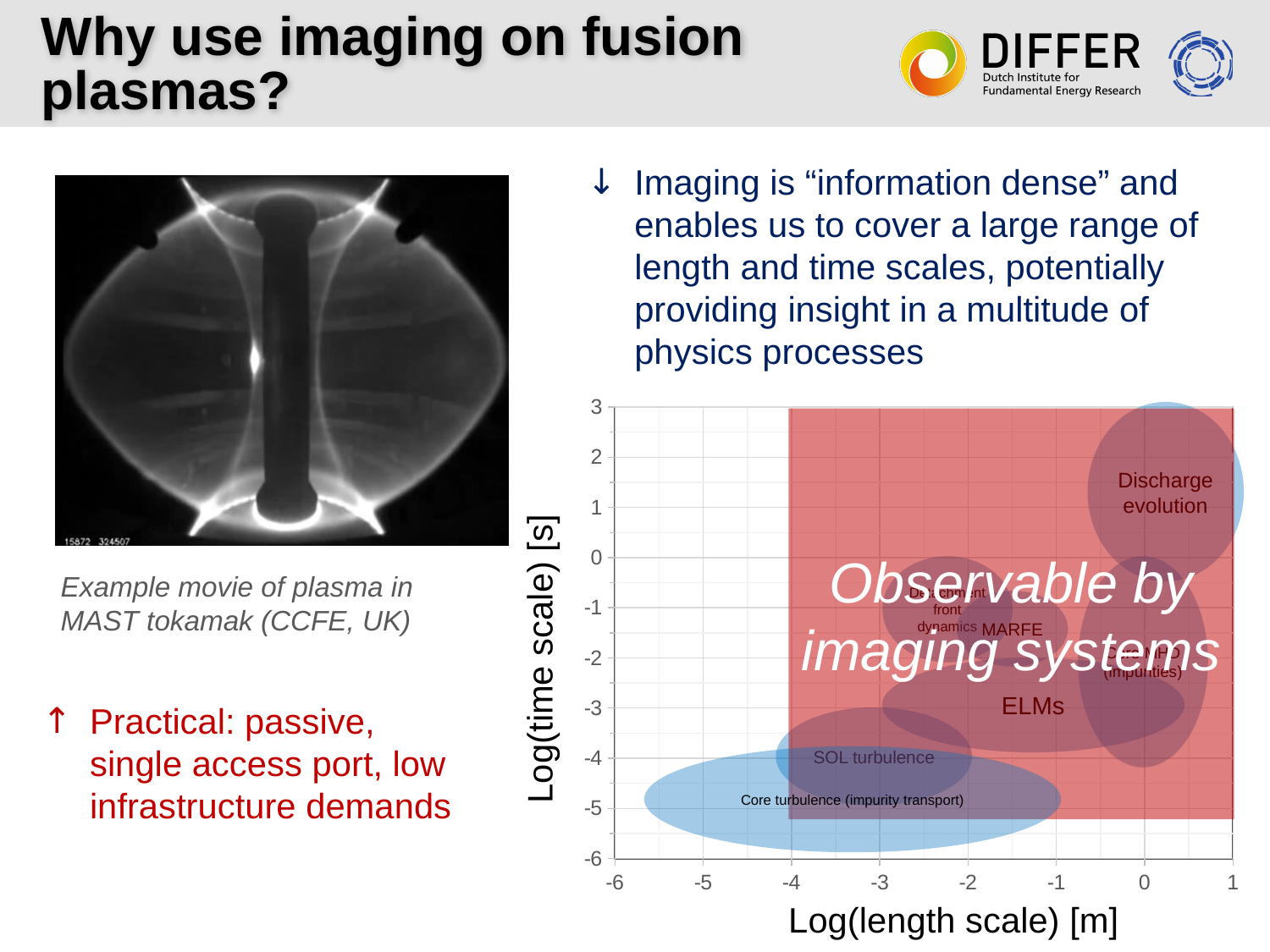
Is the Core turbulence (impurity transport) region at a log time scale greater or less than -3? less Which is at a larger time scale on the chart, ELMs or Discharge evolution? Discharge evolution Is the Discharge evolution region centred at a log time scale greater or less than 0? greater Which labeled process extends to the smallest length scale on the chart? Core turbulence (impurity transport) Is the SOL turbulence region at a log time scale greater or less than -2? less Which is at a larger length scale on the chart, Core turbulence (impurity transport) or ELMs? ELMs How many labeled physics processes (ellipses) are shown on the chart? 7 Which labeled process sits at the lowest time scale on the chart? Core turbulence (impurity transport) What is the label of the x axis of the chart? Log(length scale) [m] What text is written across the red shaded region of the chart? Observable by imaging systems Which labeled process sits at the highest time scale on the chart? Discharge evolution